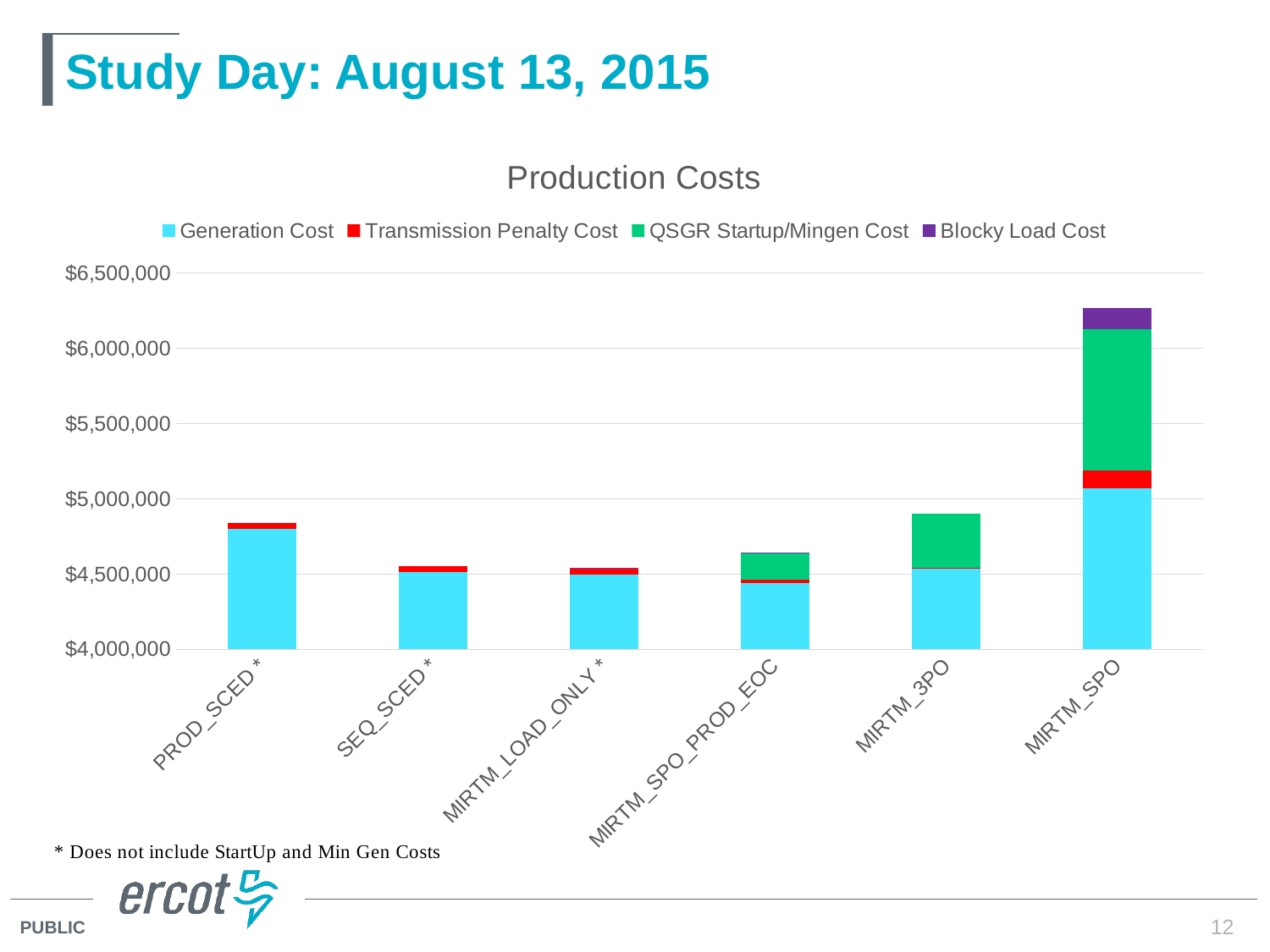
Is the total production cost for MIRTM_SPO greater or less than $6,000,000? greater How many categories are shown on the x axis? 6 Which category has the highest total production cost? MIRTM_SPO Is the total production cost for PROD_SCED* greater or less than $5,000,000? less Which has the larger total production cost, PROD_SCED* or MIRTM_SPO? MIRTM_SPO Which category is the only one with a Blocky Load Cost segment? MIRTM_SPO Which has the larger total production cost, MIRTM_3PO or MIRTM_SPO_PROD_EOC? MIRTM_3PO What type of chart is shown on the slide? Stacked bar chart Is the total production cost for MIRTM_3PO greater or less than $5,000,000? less How many series does the legend list? 4 What is the title of the chart? Production Costs